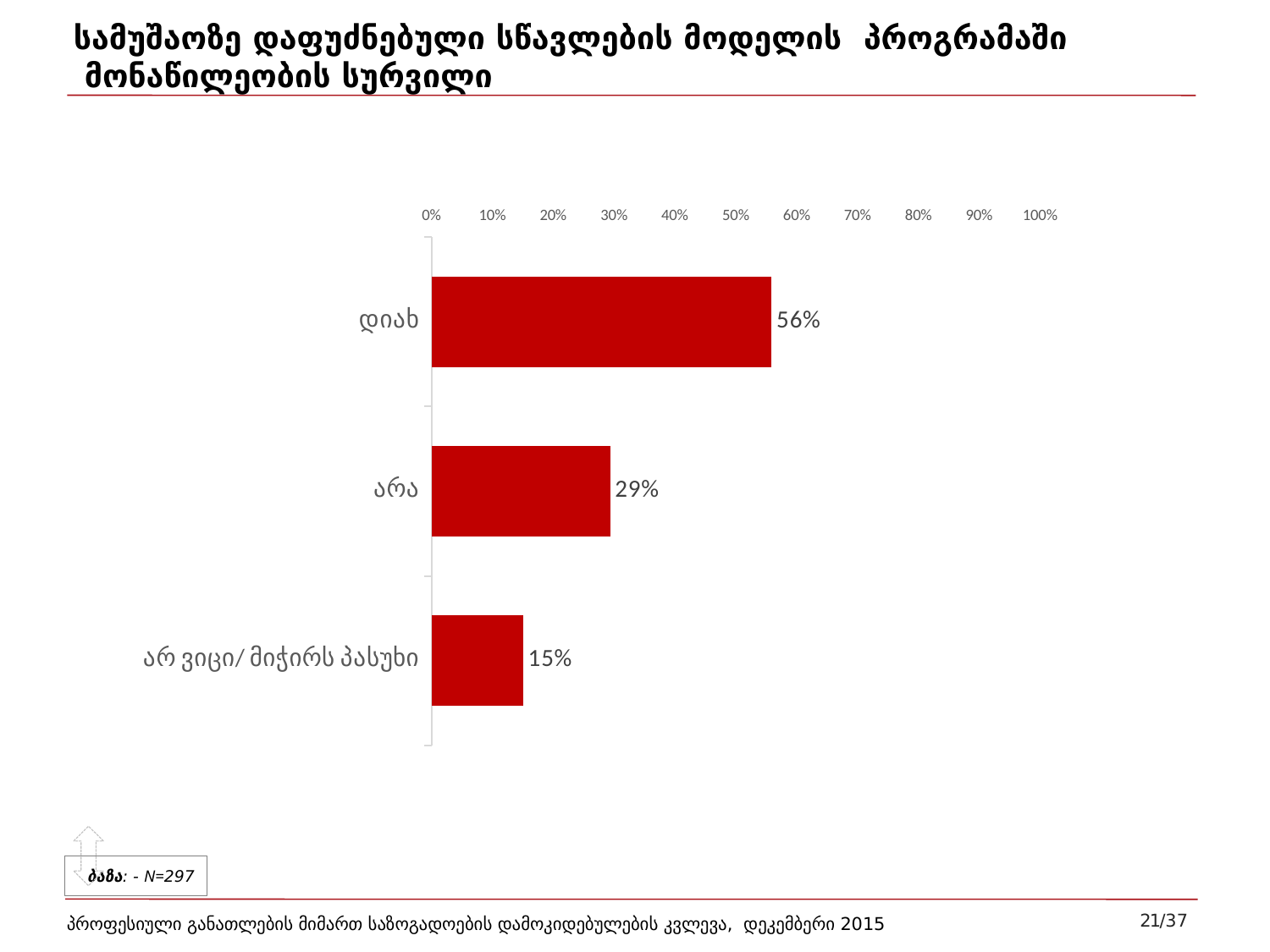
What is the difference between the values for "არა" and "არ ვიცი/ მიჭირს პასუხი"? 14% What is the value for "არა"? 29% Which is larger, the value for "არა" or the value for "არ ვიცი/ მიჭირს პასუხი"? არა Is the value for "დიახ" greater or less than 50%? greater What sample size (N) is stated in the base note on the slide? N=297 What kind of chart is shown on the slide? bar chart How many categories are shown in the chart? 3 What is the value for "არ ვიცი/ მიჭირს პასუხი"? 15% What is the value for "დიახ"? 56% What is the difference between the values for "დიახ" and "არა"? 27% Which category has the lowest value? არ ვიცი/ მიჭირს პასუხი Which category has the highest value? დიახ